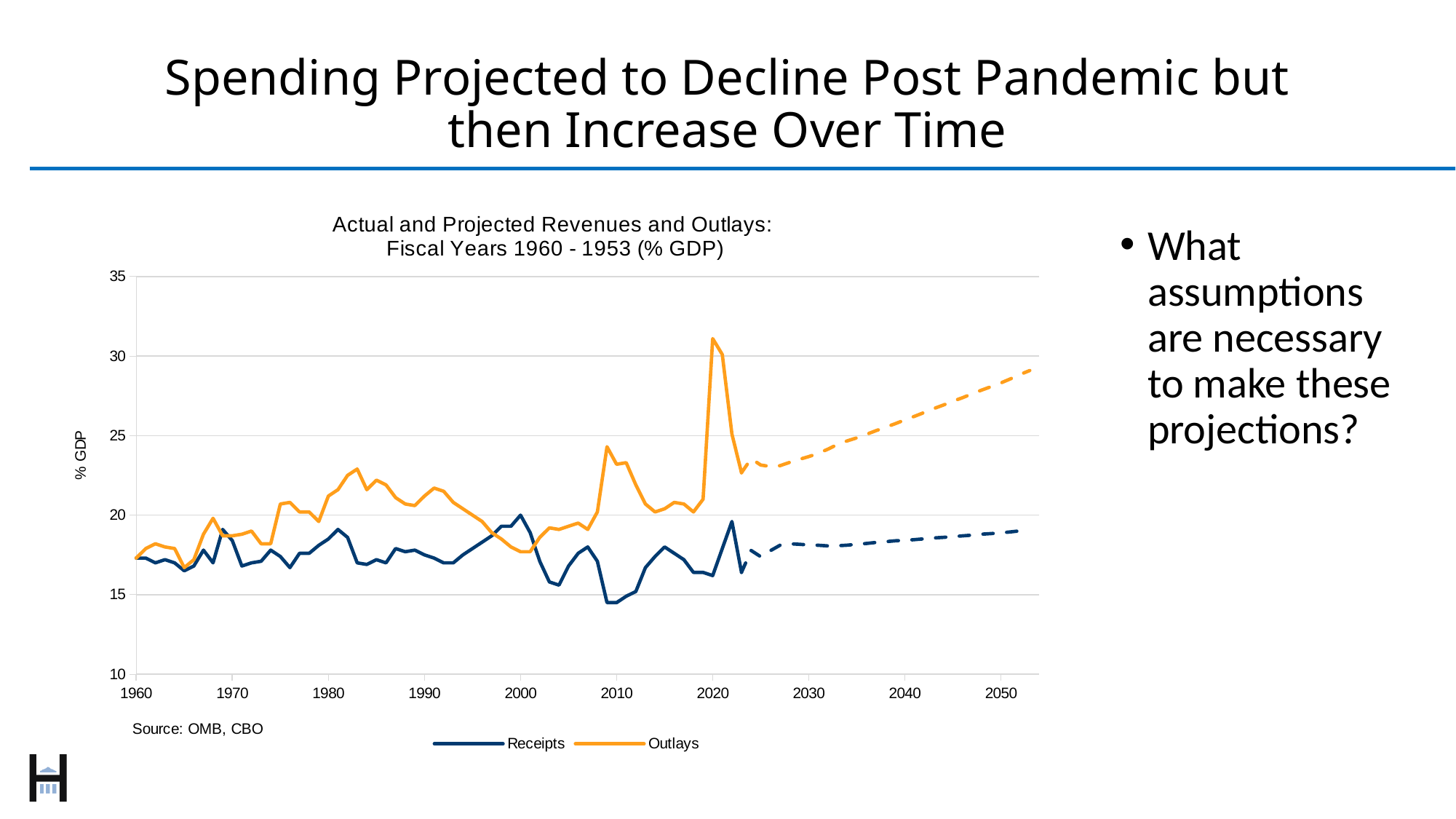
In 2000, which series has the higher value, Receipts or Outlays? Receipts Is the projected value for Receipts in 2050 greater or less than 20? less Do the projected Outlays rise or fall between 2030 and 2050? Rise Is the value for Outlays at its 2020 peak greater or less than 25? greater What kind of chart is shown on the slide? Line chart What are the two series named in the legend? Receipts and Outlays Is the projected value for Outlays in 2050 greater or less than 25? greater Which series reaches the highest value anywhere on the chart? Outlays In 2020, which series has the higher value, Receipts or Outlays? Outlays What is the label on the vertical axis of the chart? % GDP How many series does the legend list? 2